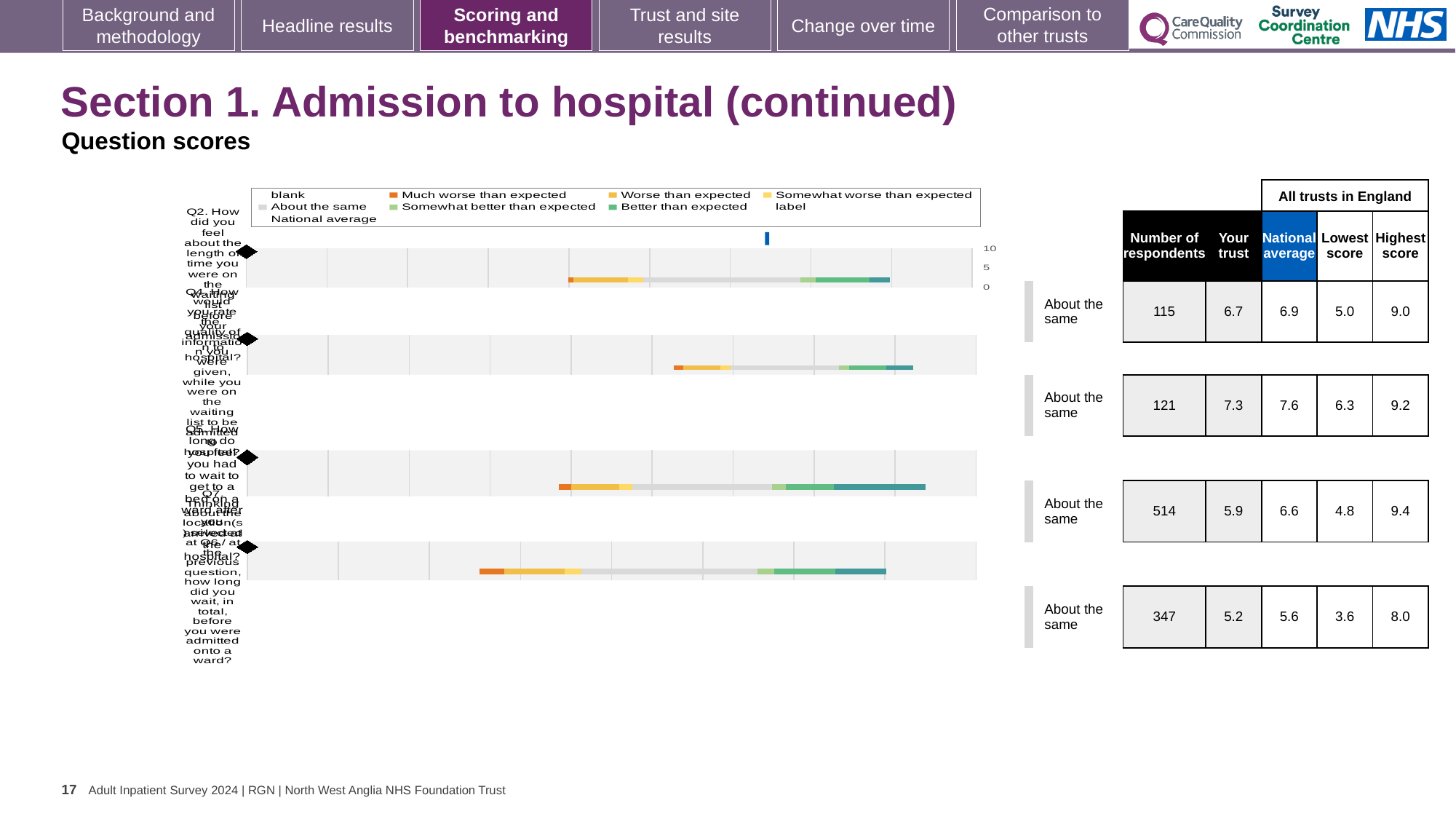
In the table beside the chart, which row has the lowest 'Your trust' score? fourth row (5.2) What is the highest value shown on the chart's axis? 10 What kind of chart is shown on the slide? bar chart In the table beside the chart, what is the national average in the fourth row? 5.6 What benchmark category is shown next to each bar in the chart? About the same In the table beside the chart, what is the number of respondents in the third row? 514 In the table beside the chart, what is the difference between the national average and 'Your trust' score in the third row? 0.7 In the table beside the chart, which row has the highest 'Your trust' score? second row (7.3) How many horizontal bars are plotted in the chart? 4 Which legend entry is shown in orange in the chart's legend? Much worse than expected In the table beside the chart, is the 'Your trust' score in the second row larger or smaller than the national average in that row? smaller In the table beside the chart, what is the 'Your trust' score in the first row? 6.7